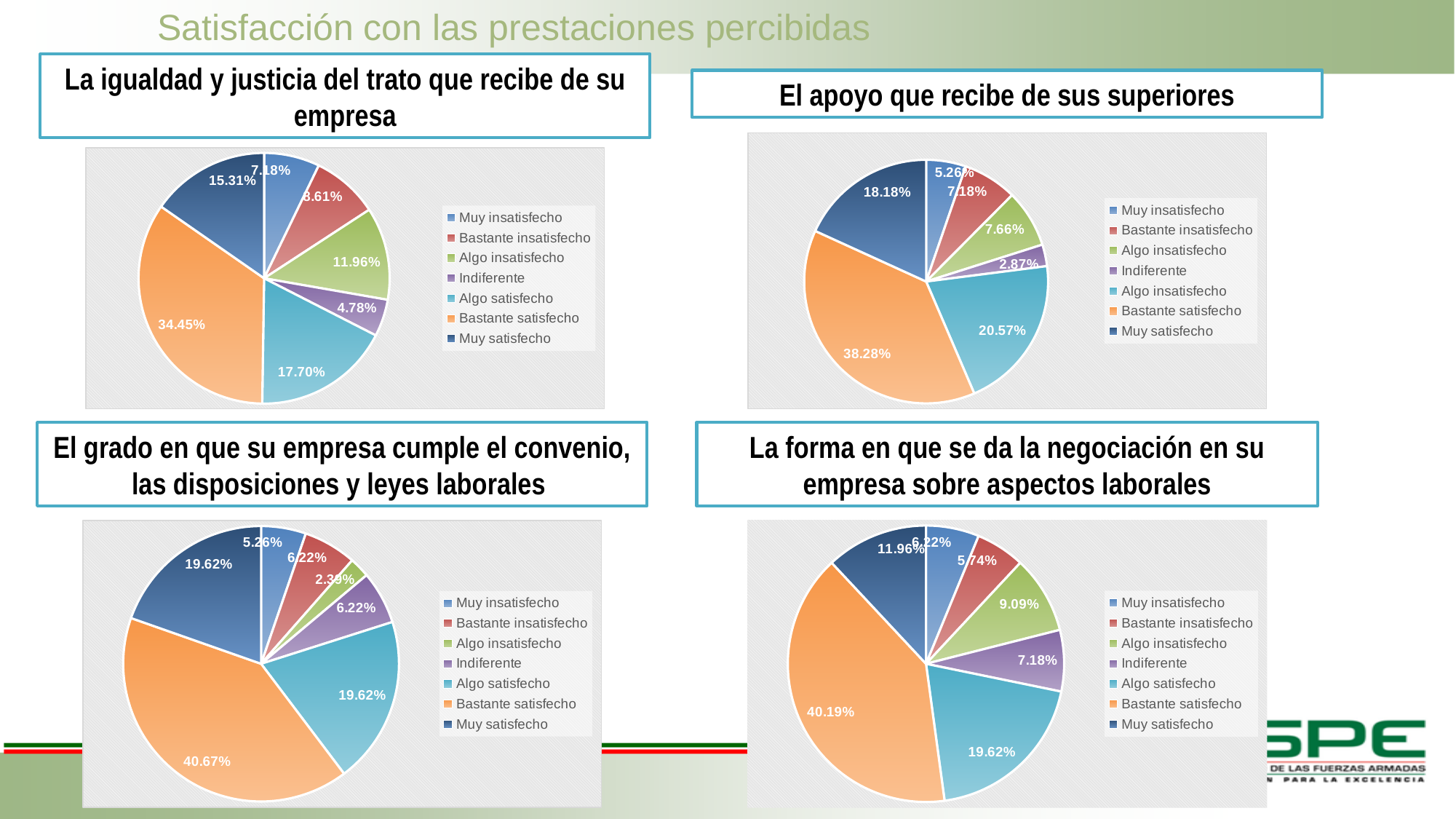
In the chart titled 'La igualdad y justicia del trato que recibe de su empresa', what percentage is shown for Bastante satisfecho? 34.45% In the chart titled 'El grado en que su empresa cumple el convenio, las disposiciones y leyes laborales', which is larger: Bastante satisfecho or Algo satisfecho? Bastante satisfecho In the chart titled 'El apoyo que recibe de sus superiores', which category has the largest slice? Bastante satisfecho In the chart titled 'El apoyo que recibe de sus superiores', what is the difference between Muy satisfecho and Muy insatisfecho? 12.92% In the chart titled 'La igualdad y justicia del trato que recibe de su empresa', what colour is the Bastante satisfecho slice? Orange In the chart titled 'La forma en que se da la negociación en su empresa sobre aspectos laborales', what percentage is shown for Muy satisfecho? 11.96% In the chart titled 'La igualdad y justicia del trato que recibe de su empresa', which category has the smallest slice? Indiferente In the chart titled 'El apoyo que recibe de sus superiores', what percentage is shown for Algo satisfecho? 20.57% How many categories does the legend list in the chart titled 'La forma en que se da la negociación en su empresa sobre aspectos laborales'? 7 In the chart titled 'La forma en que se da la negociación en su empresa sobre aspectos laborales', what is the difference between Bastante satisfecho and Algo satisfecho? 20.57% What kind of chart is used in the chart titled 'El apoyo que recibe de sus superiores'? Pie chart In the chart titled 'El grado en que su empresa cumple el convenio, las disposiciones y leyes laborales', what percentage is shown for Algo insatisfecho? 2.39%